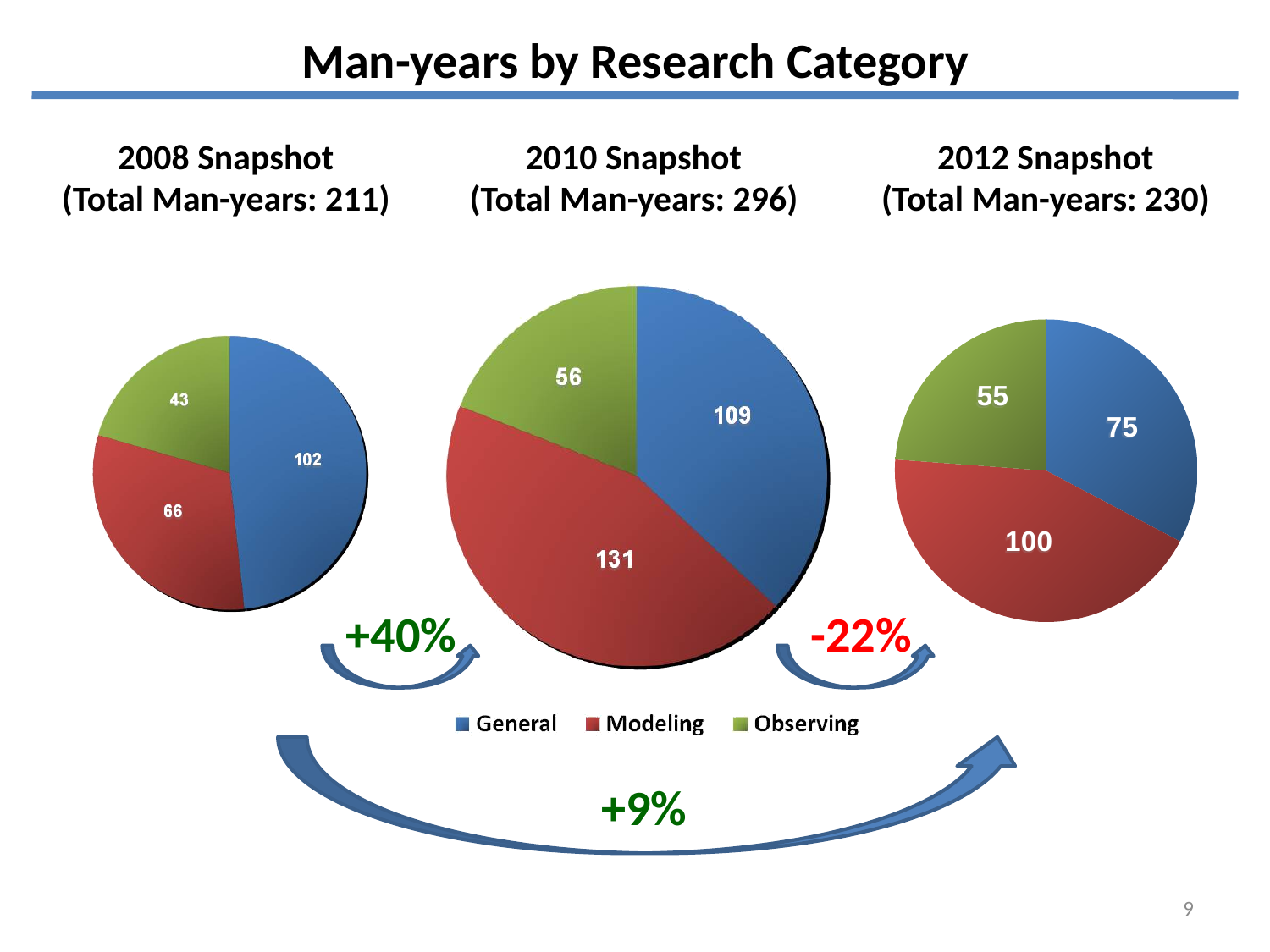
In the 2010 Snapshot pie chart, how many man-years are in the Modeling category? 131 What kind of chart is used for the 2010 Snapshot? Pie chart In the 2012 Snapshot pie chart, which category has the largest number of man-years? Modeling In the 2008 Snapshot pie chart, how many man-years are in the General category? 102 In the 2008 Snapshot pie chart, which category has the largest number of man-years? General In the 2012 Snapshot pie chart, how many man-years are in the Observing category? 55 In the 2012 Snapshot pie chart, which is larger, General or Modeling? Modeling How many slices does the 2008 Snapshot pie chart have? 3 In the 2010 Snapshot pie chart, what is the difference in man-years between Modeling and General? 22 In the 2010 Snapshot pie chart, which category has the smallest number of man-years? Observing How many categories does the legend list? 3